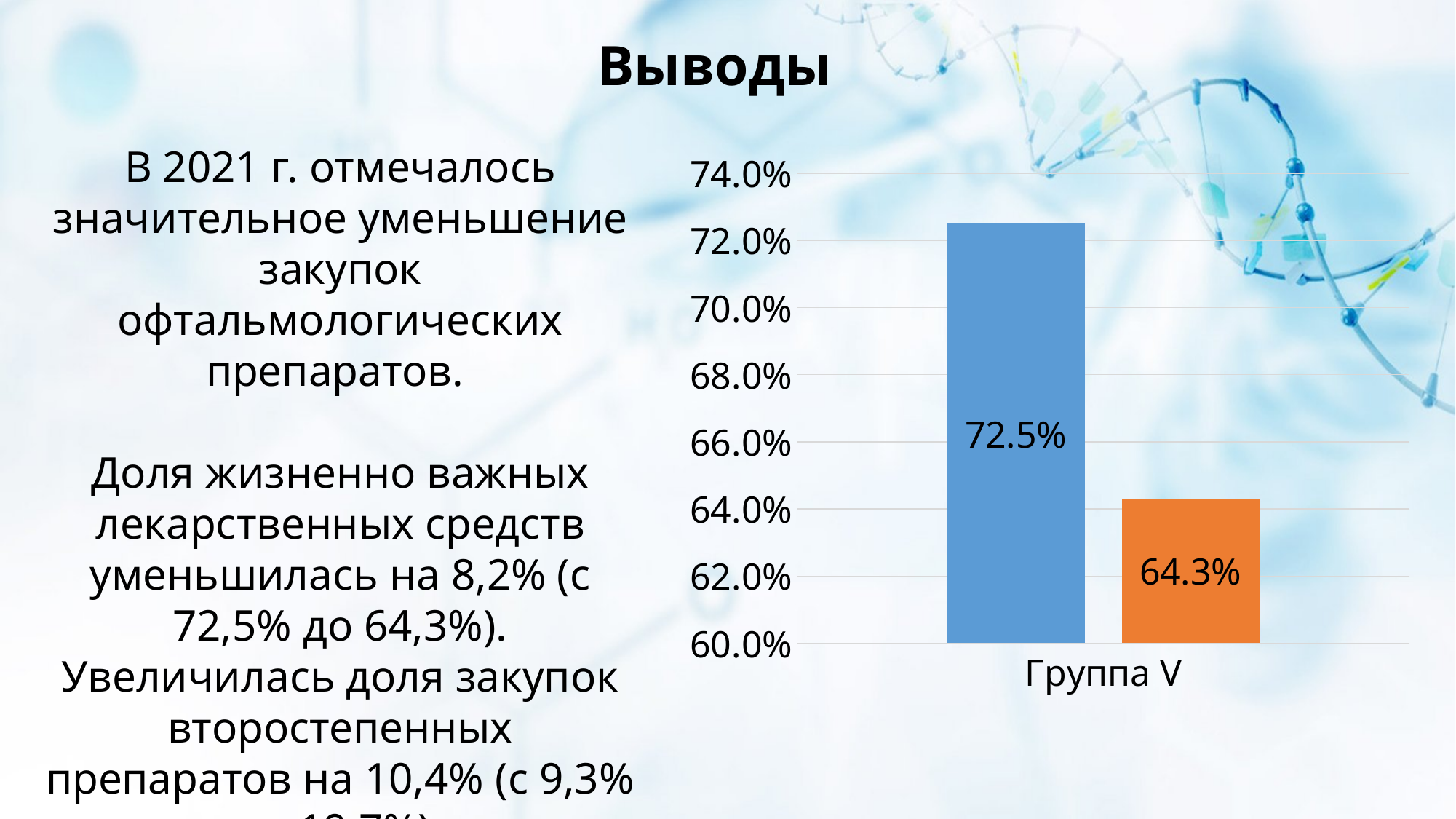
What kind of chart is shown on the slide? bar chart Is the value of the orange bar greater or less than 66.0%? less What is the label of the category on the x axis? Группа V What value is shown on the blue bar for Группа V? 72.5% What value is shown on the orange bar for Группа V? 64.3% How many bars are plotted on the chart? 2 Which bar is taller, the blue one or the orange one? the blue one What is the difference between the blue bar value and the orange bar value? 8.2% Which bar has the lowest value on the chart? the orange bar (64.3%) How many categories are shown on the x axis of the chart? 1 What is the highest tick value shown on the y axis? 74.0% Is the value of the blue bar greater or less than 70.0%? greater